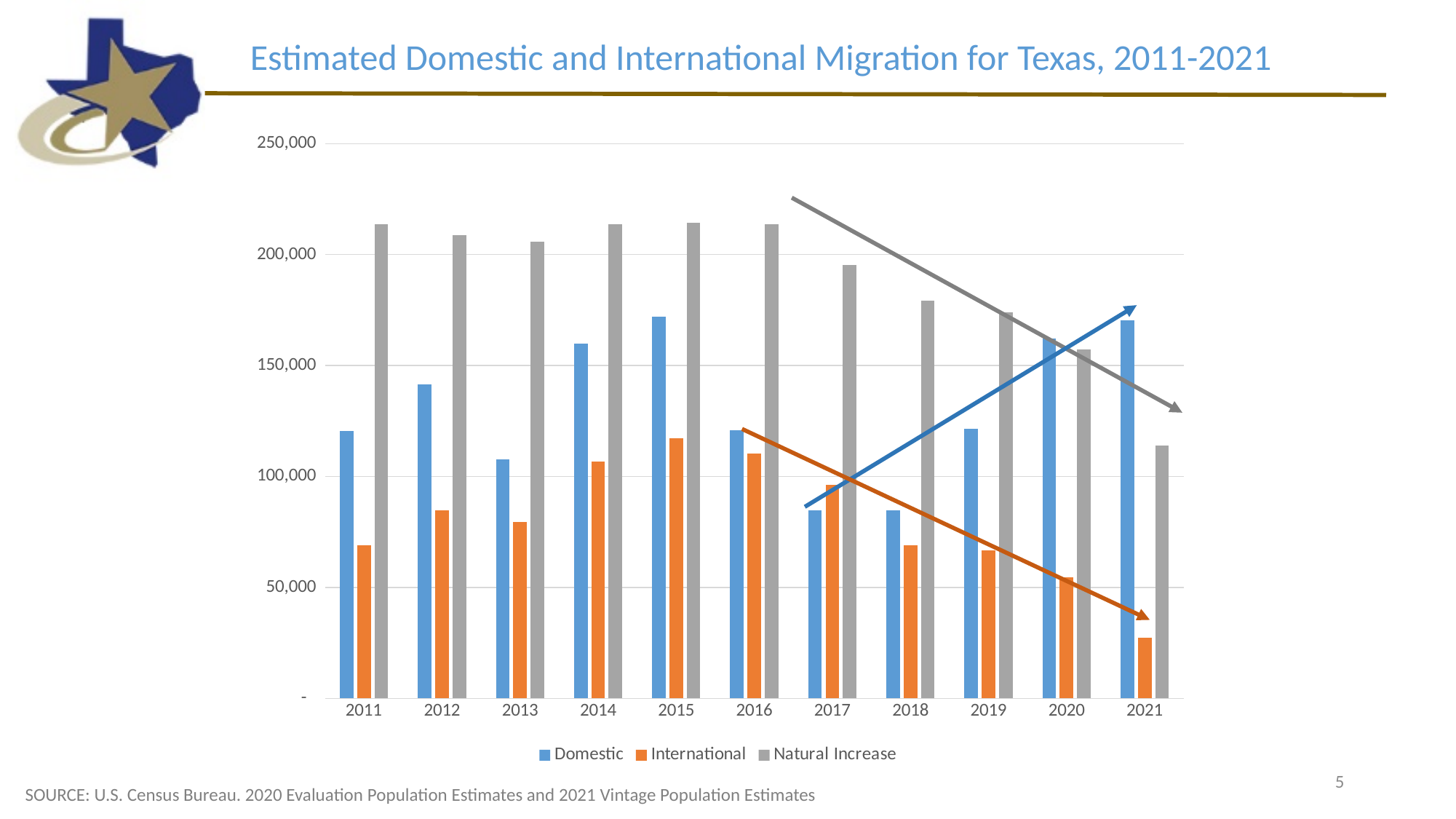
Is the Domestic value for 2015 greater or less than 150,000? greater What kind of chart is shown on the slide? Bar chart How many series does the legend list? 3 Which year has the lowest Natural Increase value? 2021 How many years are shown along the x axis? 11 Which year has the lowest International value? 2021 Which year has the highest International value? 2015 Is the International value for 2021 greater or less than 50,000? less In 2021, which is larger: Domestic or Natural Increase? Domestic Do the International values rise or fall from 2015 to 2021? Fall Which series is shown in orange in the legend? International Is the Natural Increase value for 2011 greater or less than 200,000? greater